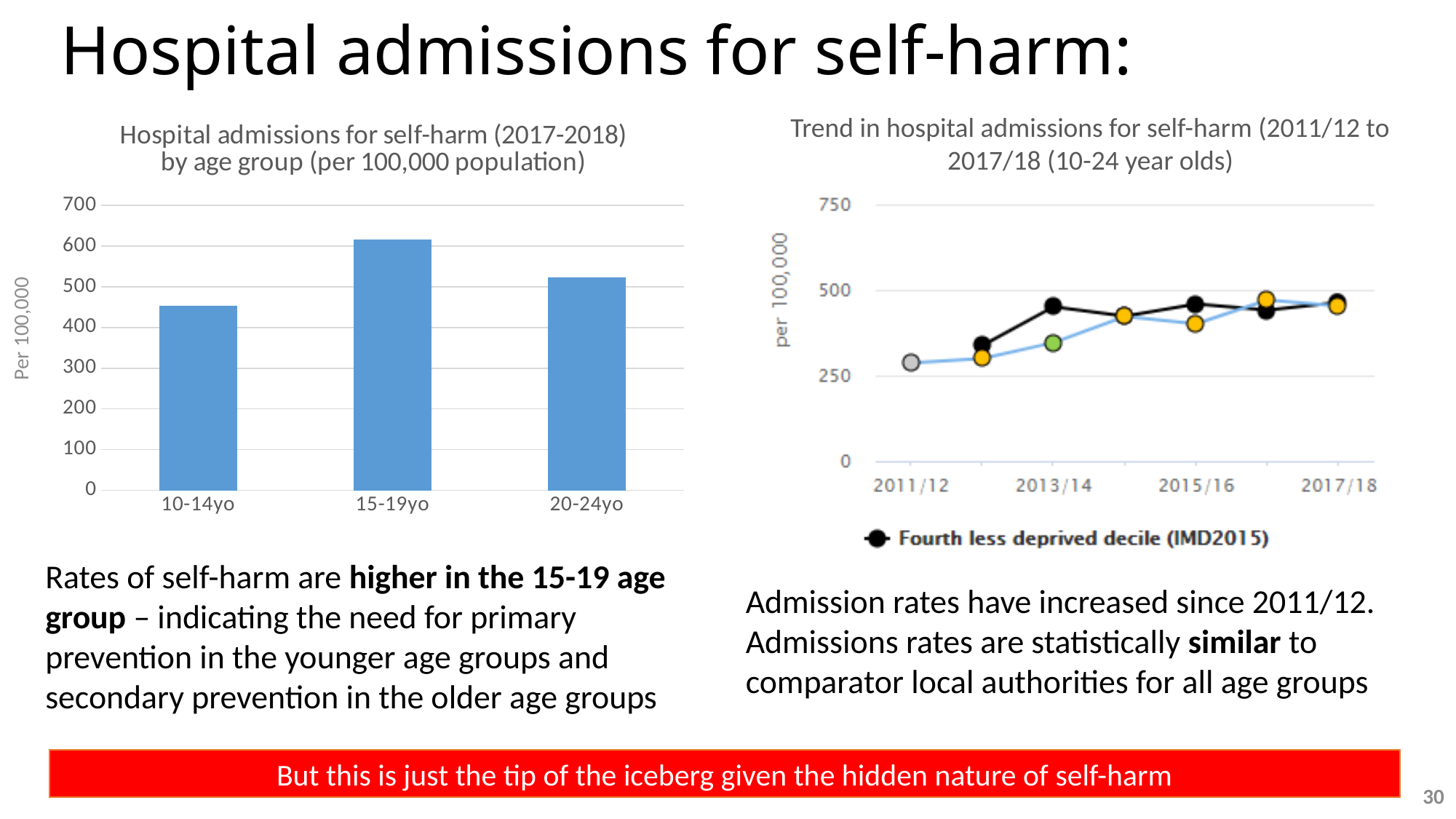
In the left bar chart, which has the higher value: 20-24yo or 10-14yo? 20-24yo In the left bar chart, is the value for 10-14yo greater or less than 500? less What kind of chart is the left chart, 'Hospital admissions for self-harm (2017-2018) by age group'? bar chart In the right line chart, do admission rates generally rise or fall from 2011/12 to 2017/18? rise In the left bar chart, which age group has the lowest rate of hospital admissions for self-harm? 10-14yo In the left bar chart, which age group has the highest rate of hospital admissions for self-harm? 15-19yo What kind of chart is the right chart, 'Trend in hospital admissions for self-harm'? line chart In the left bar chart, is the value for 20-24yo greater or less than 500? greater In the left bar chart, is the value for 15-19yo greater or less than 600? greater What is the y-axis label of the left bar chart? Per 100,000 How many age groups are shown in the left bar chart? 3